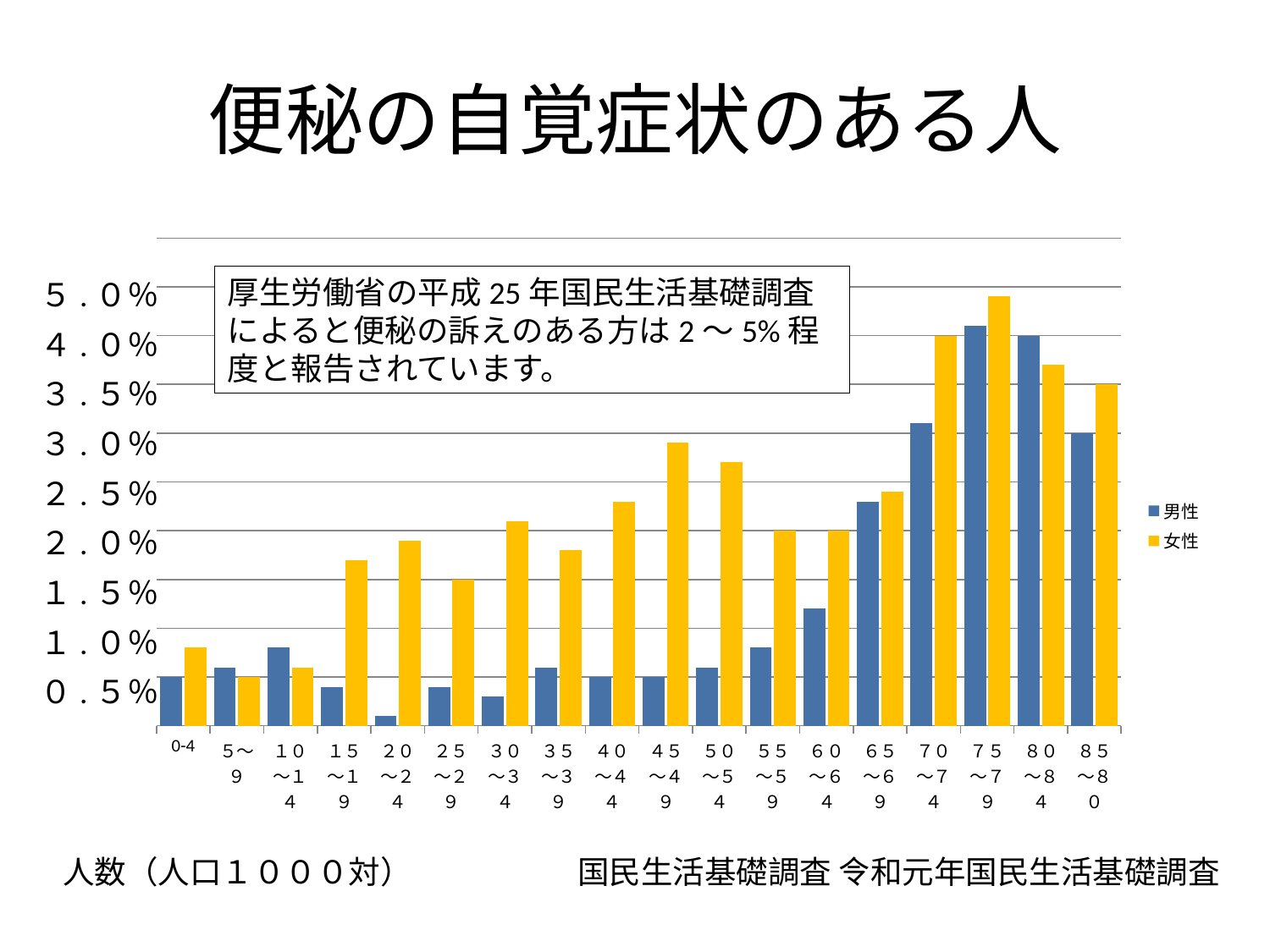
Is the value for 男性 in the 60～64 category greater or less than 1.5%? less How many series does the legend list? 2 What are the two series named in the legend? 男性 and 女性 Do the 男性 values rise or fall from the 60～64 category to the 75～79 category? rise Is the value for 女性 in the 75～79 category greater or less than 4.0%? greater What kind of chart is shown on the slide? bar chart Which age category has the lowest value for 男性? 20～24 Which age category has the highest value for 男性? 75～79 How many age categories are shown on the x axis? 18 In the 45～49 category, which is larger, 男性 or 女性? 女性 Which age category has the highest value for 女性? 75～79 Is the value for 女性 in the 45～49 category greater or less than 2.5%? greater